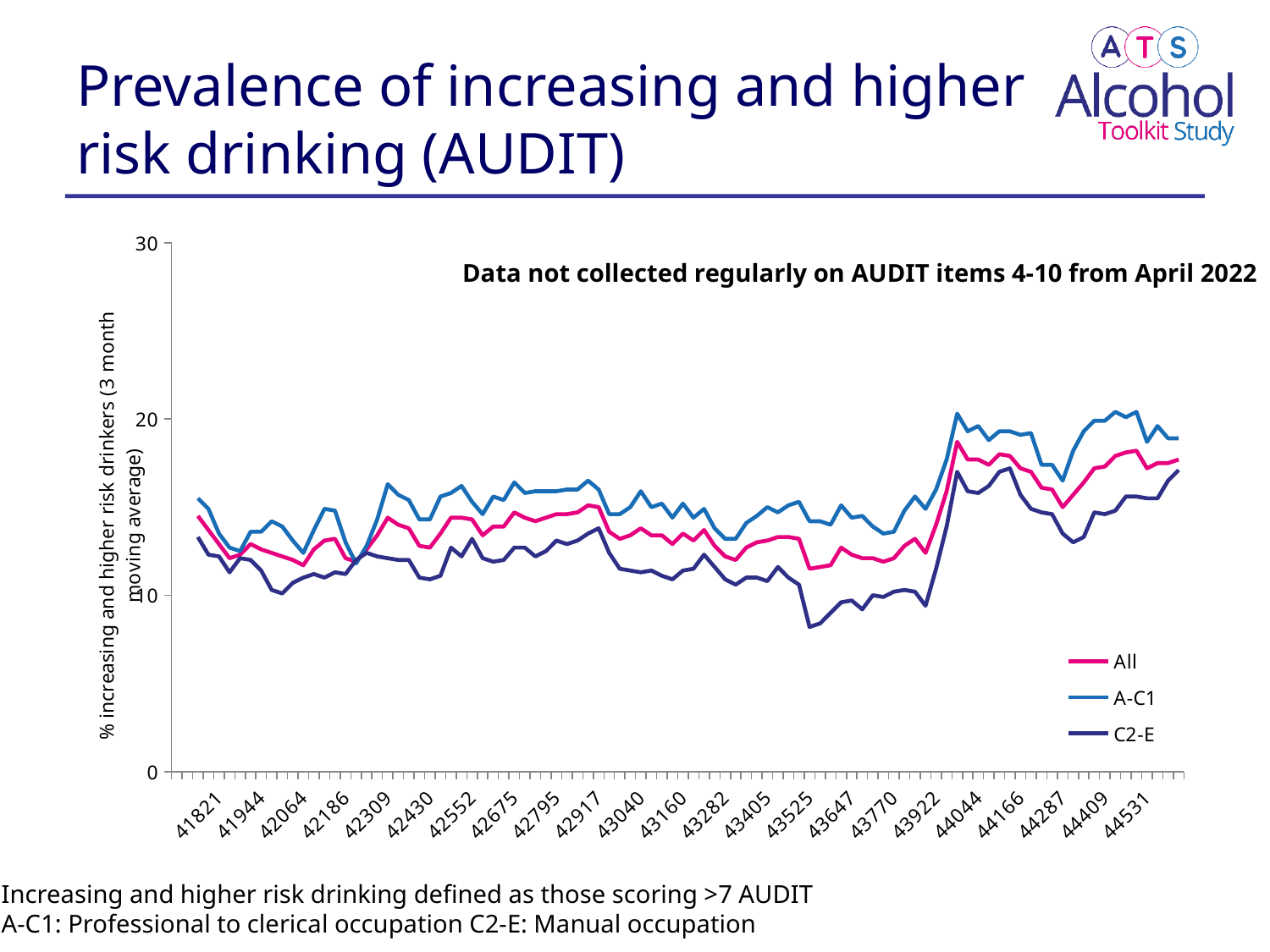
What kind of chart is shown on the slide? line chart Which series is plotted consistently lowest across the chart? C2-E Is the value for All at 41821 greater or less than 10? greater At 43525, which series has the larger value, A-C1 or C2-E? A-C1 Do the values for All rise or fall between 43770 and 44044? rise How many series does the legend list? 3 Which series is plotted consistently highest across the chart? A-C1 What does the annotation text inside the chart say? Data not collected regularly on AUDIT items 4-10 from April 2022 Is the value for C2-E at 43525 greater or less than 10? less Is the value for A-C1 at 42309 greater or less than 20? less What is the highest tick value shown on the y axis? 30